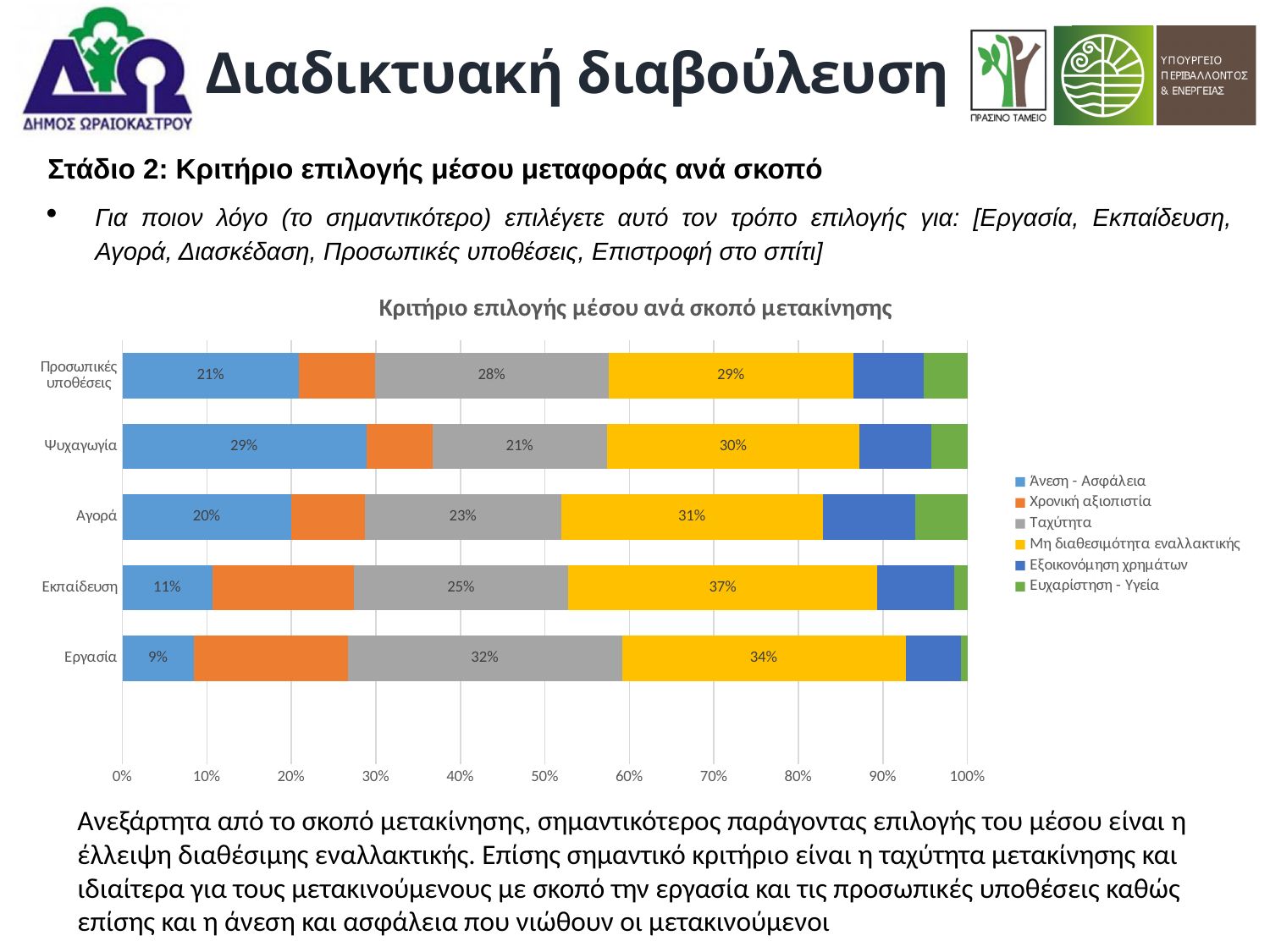
What is the value of Μη διαθεσιμότητα εναλλακτικής for Εκπαίδευση? 37% What is the Άνεση - Ασφάλεια value for Ψυχαγωγία? 29% What is the difference between the Ταχύτητα values for Εργασία and Ψυχαγωγία? 11% What is the Ταχύτητα value for Προσωπικές υποθέσεις? 28% Which purpose has the lowest labelled value for Άνεση - Ασφάλεια? Εργασία What percentage does Άνεση - Ασφάλεια account for in the Εργασία bar? 9% Which legend entry is shown in yellow? Μη διαθεσιμότητα εναλλακτικής Which is larger: the Μη διαθεσιμότητα εναλλακτικής value for Αγορά or for Ψυχαγωγία? Αγορά How many purposes of travel are shown on the vertical axis? 5 Which purpose has the highest labelled value for Μη διαθεσιμότητα εναλλακτικής? Εκπαίδευση How many series does the legend list? 6 What type of chart is shown? Stacked bar chart